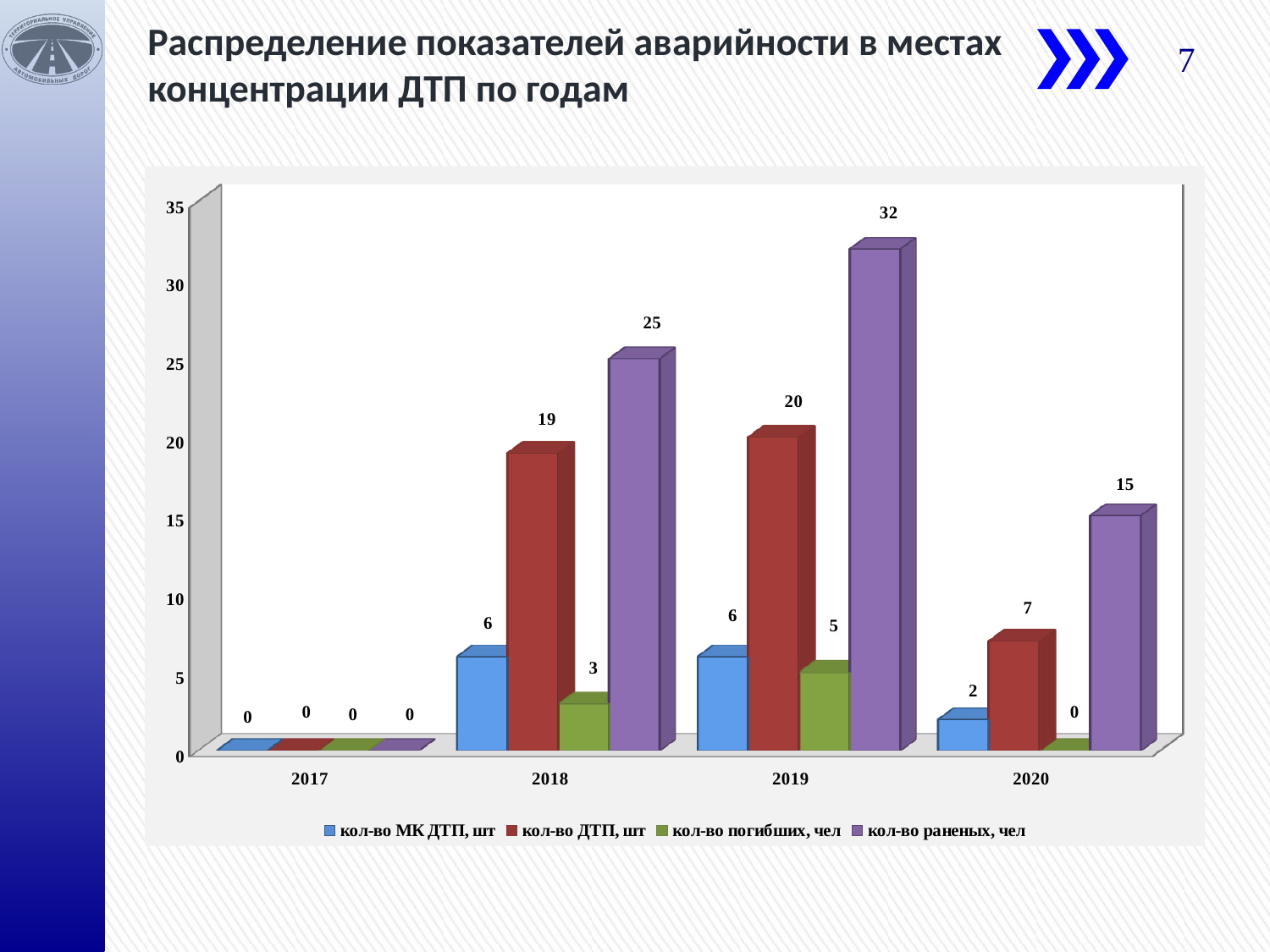
Which is larger: кол-во погибших, чел in 2019 or in 2018? 2019 In which year is кол-во раненых, чел highest? 2019 What is the value of кол-во раненых, чел for 2019? 32 Which colour represents кол-во раненых, чел in the legend? Purple How many years are shown on the x axis? 4 What is the value of кол-во ДТП, шт for 2018? 19 What is the value of кол-во МК ДТП, шт for 2020? 2 In which year is кол-во ДТП, шт lowest? 2017 What is the difference between кол-во раненых, чел in 2019 and in 2018? 7 What is the value of кол-во погибших, чел for 2020? 0 What kind of chart is shown on the slide? Bar chart How many series does the legend list? 4